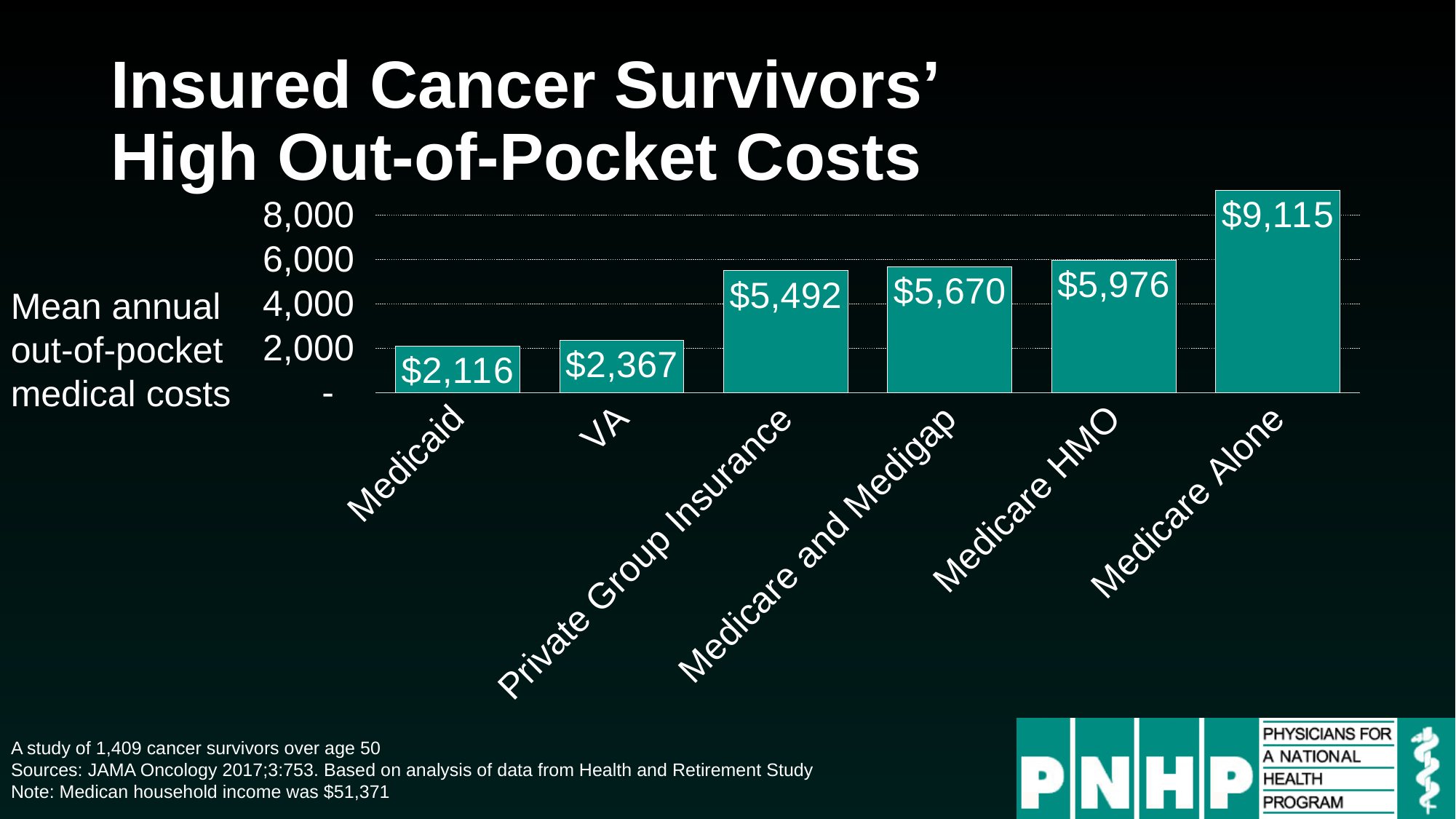
Do the values rise or fall moving from left to right across the categories? Rise Which insurance category has the lowest mean annual out-of-pocket medical cost? Medicaid How many insurance categories are shown in the chart? 6 What is the mean annual out-of-pocket medical cost for Medicare HMO? $5,976 What kind of chart is shown on the slide? Bar chart Which has a higher mean annual out-of-pocket cost, VA or Private Group Insurance? Private Group Insurance What is the difference between the out-of-pocket costs for Medicare Alone and Medicaid? $6,999 What is the mean annual out-of-pocket medical cost for Private Group Insurance? $5,492 What is the mean annual out-of-pocket medical cost for Medicare Alone? $9,115 Which insurance category has the highest mean annual out-of-pocket medical cost? Medicare Alone What is the difference between the out-of-pocket costs for Medicare HMO and Medicare and Medigap? $306 What is the mean annual out-of-pocket medical cost for Medicaid? $2,116